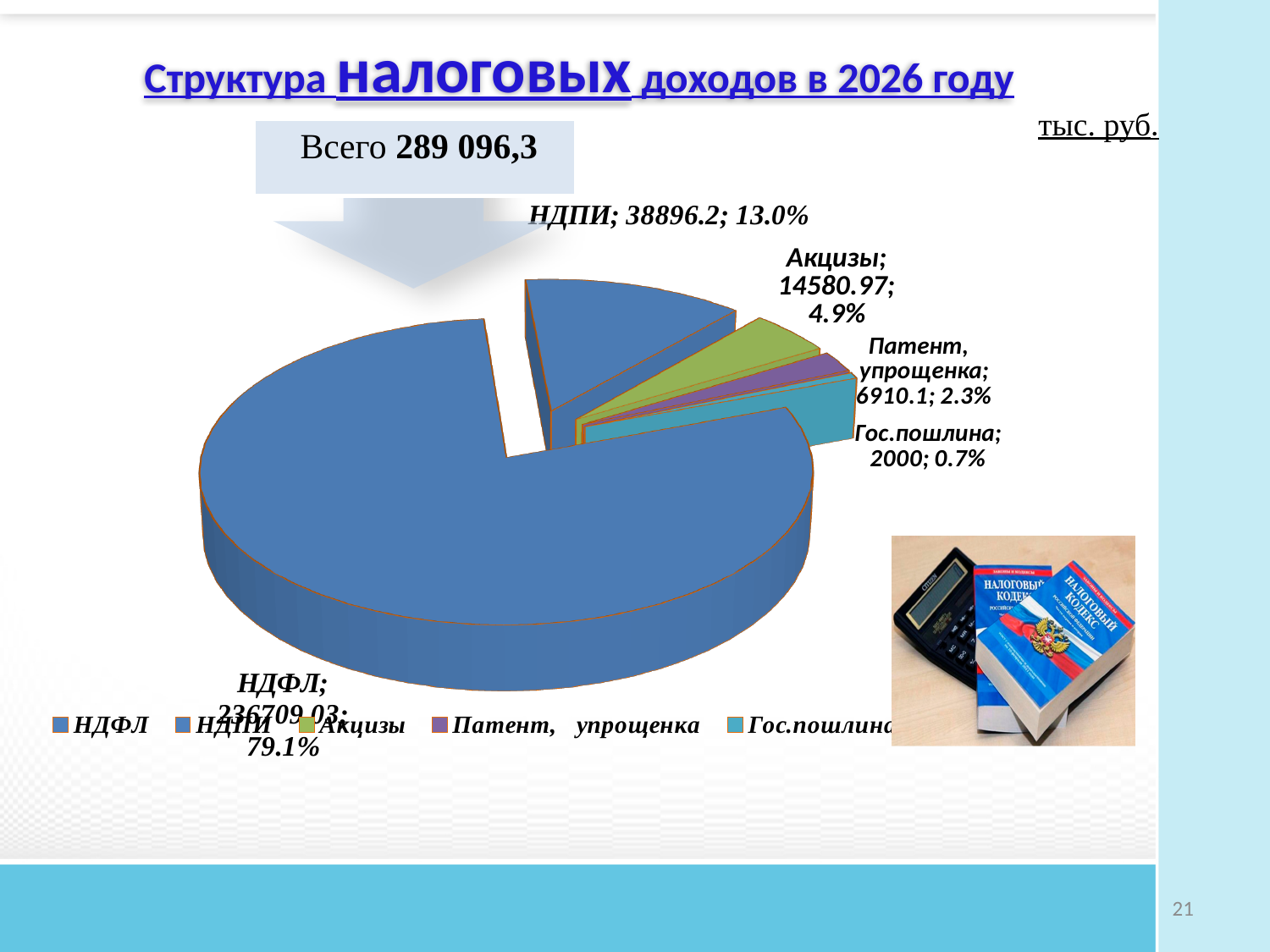
What is the value for Гос.пошлина in the pie chart? 2000 What is the value for НДПИ in the pie chart? 38896.2 Which category has the largest slice of the pie? НДФЛ Which category has the smallest slice of the pie? Гос.пошлина What is the value for Акцизы in the pie chart? 14580.97 What is the value for Патент, упрощенка in the pie chart? 6910.1 What kind of chart is shown on the slide? pie chart What share of the pie does НДФЛ represent? 79.1% How many categories does the legend list? 5 What share of the pie does Акцизы represent? 4.9% What share of the pie does НДПИ represent? 13.0%